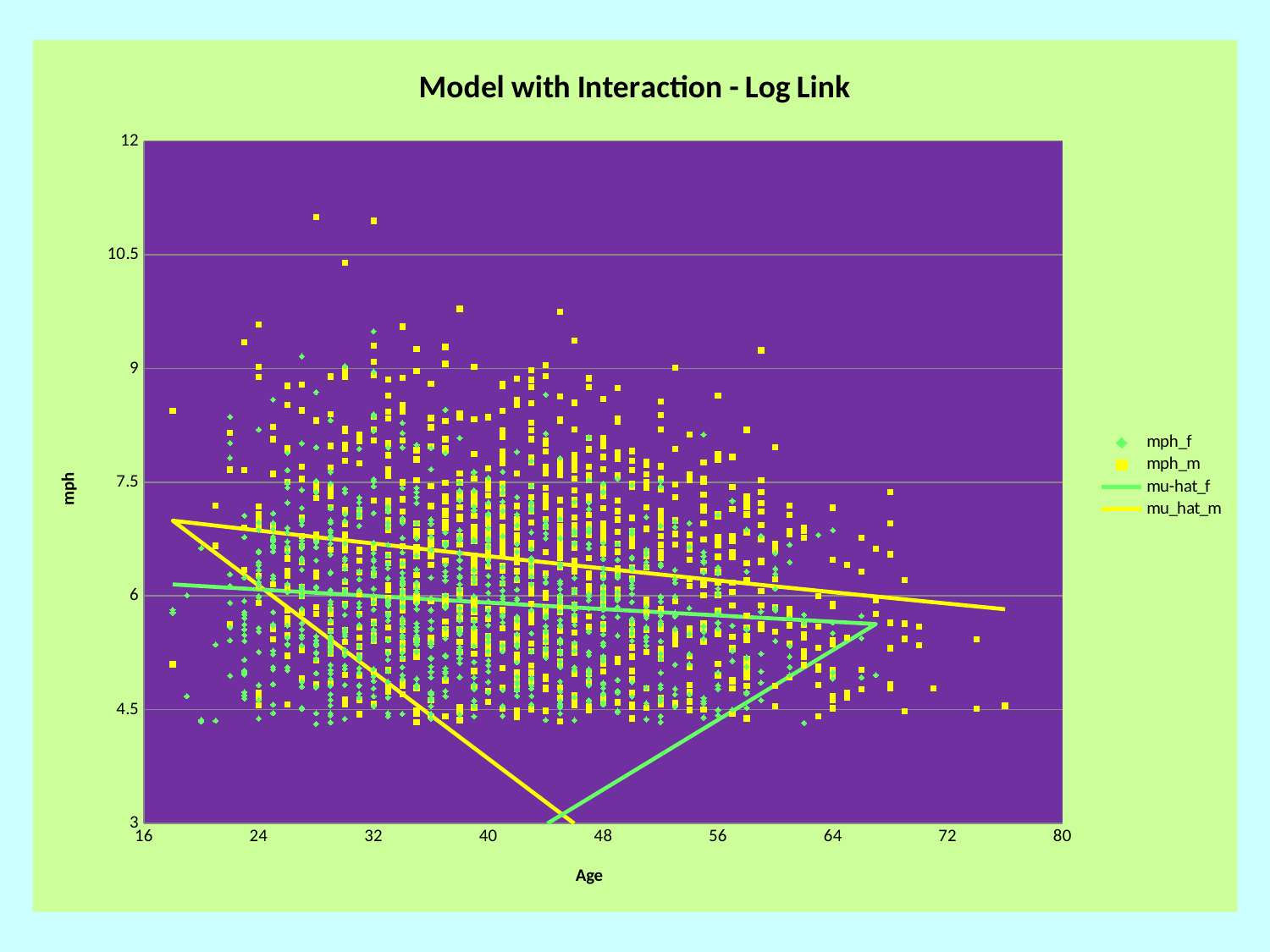
Is the value of the mu_hat_m line at Age 24 greater or less than 6? greater Is the highest mph_m point on the chart greater or less than 10.5? greater Is the value of the mu_hat_m line at Age 32 greater or less than 7.5? less At Age 24, which fitted line is higher, mu_hat_m or mu-hat_f? mu_hat_m Does the mu-hat_f fitted line rise or fall as Age increases? fall What is the title of the chart? Model with Interaction - Log Link At Age 40, which fitted line is higher, mu_hat_m or mu-hat_f? mu_hat_m Does the mu_hat_m fitted line rise or fall as Age increases? fall What kind of chart is shown on the slide? scatter chart What are the four entries listed in the legend? mph_f, mph_m, mu-hat_f, mu_hat_m How many series does the legend list? 4